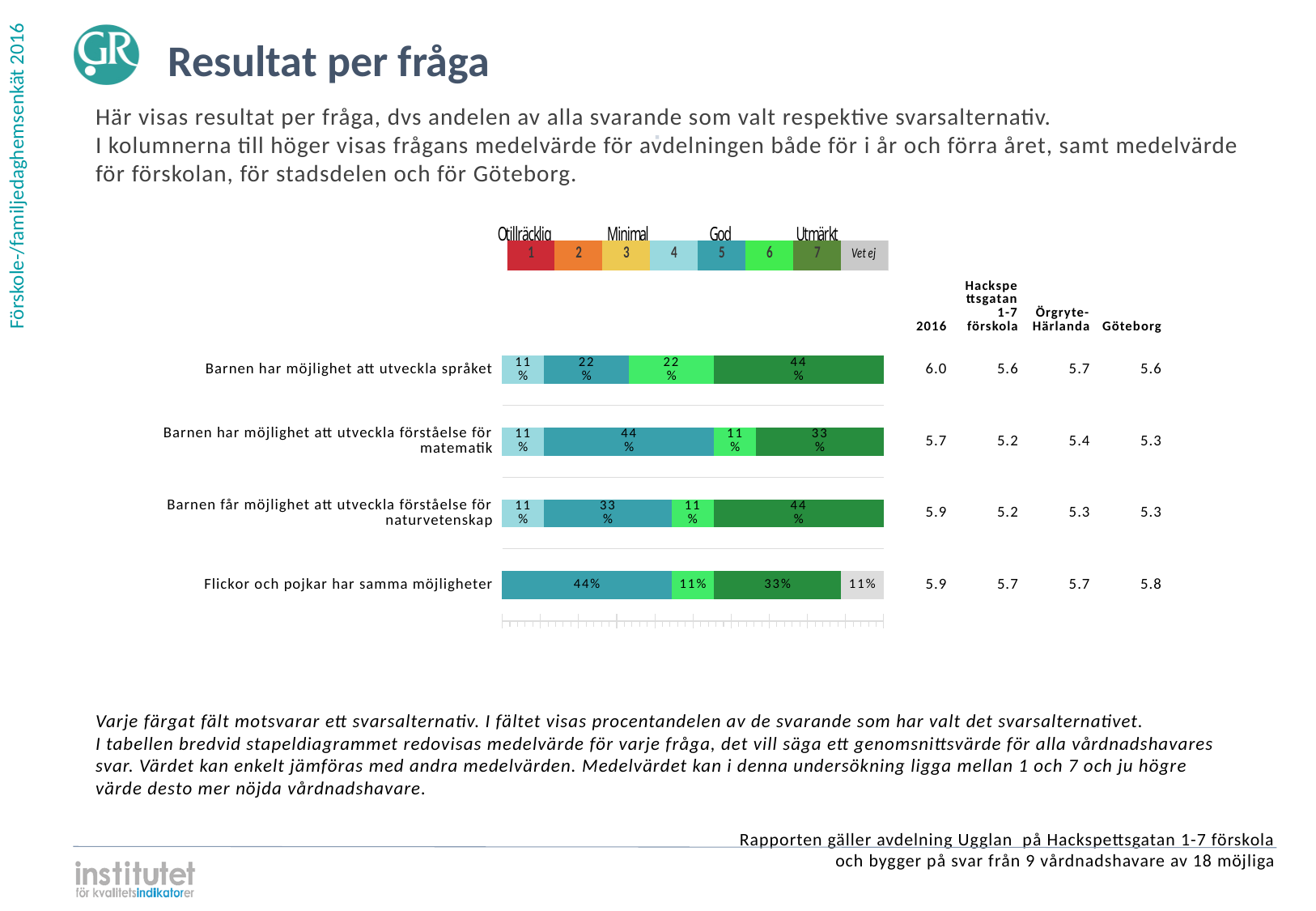
What is the difference between the option 7 share and the option 6 share for 'Barnen har möjlighet att utveckla förståelse för matematik'? 22 percentage points How many response options does the legend above the chart list, including 'Vet ej'? 8 What is the 2016 mean value shown for 'Barnen har möjlighet att utveckla språket'? 6.0 Which question has the largest share of respondents choosing option 5 (teal)? Barnen har möjlighet att utveckla förståelse för matematik (tied with Flickor och pojkar har samma möjligheter, 44%) What percentage of respondents chose option 6 (bright green) for 'Barnen får möjlighet att utveckla förståelse för naturvetenskap'? 11% For 'Barnen har möjlighet att utveckla språket', which is larger: the share choosing option 7 or the share choosing option 5? Option 7 (44%) What percentage of respondents chose option 5 (teal) for 'Barnen har möjlighet att utveckla förståelse för matematik'? 44% What label does the legend give to the scale value 1? Otillräcklig How many questions (categories) are plotted in the bar chart? 4 What kind of chart is shown on the slide? Stacked bar chart What percentage of respondents chose option 7 (dark green) for 'Barnen har möjlighet att utveckla språket'? 44% What percentage of respondents answered 'Vet ej' for 'Flickor och pojkar har samma möjligheter'? 11%